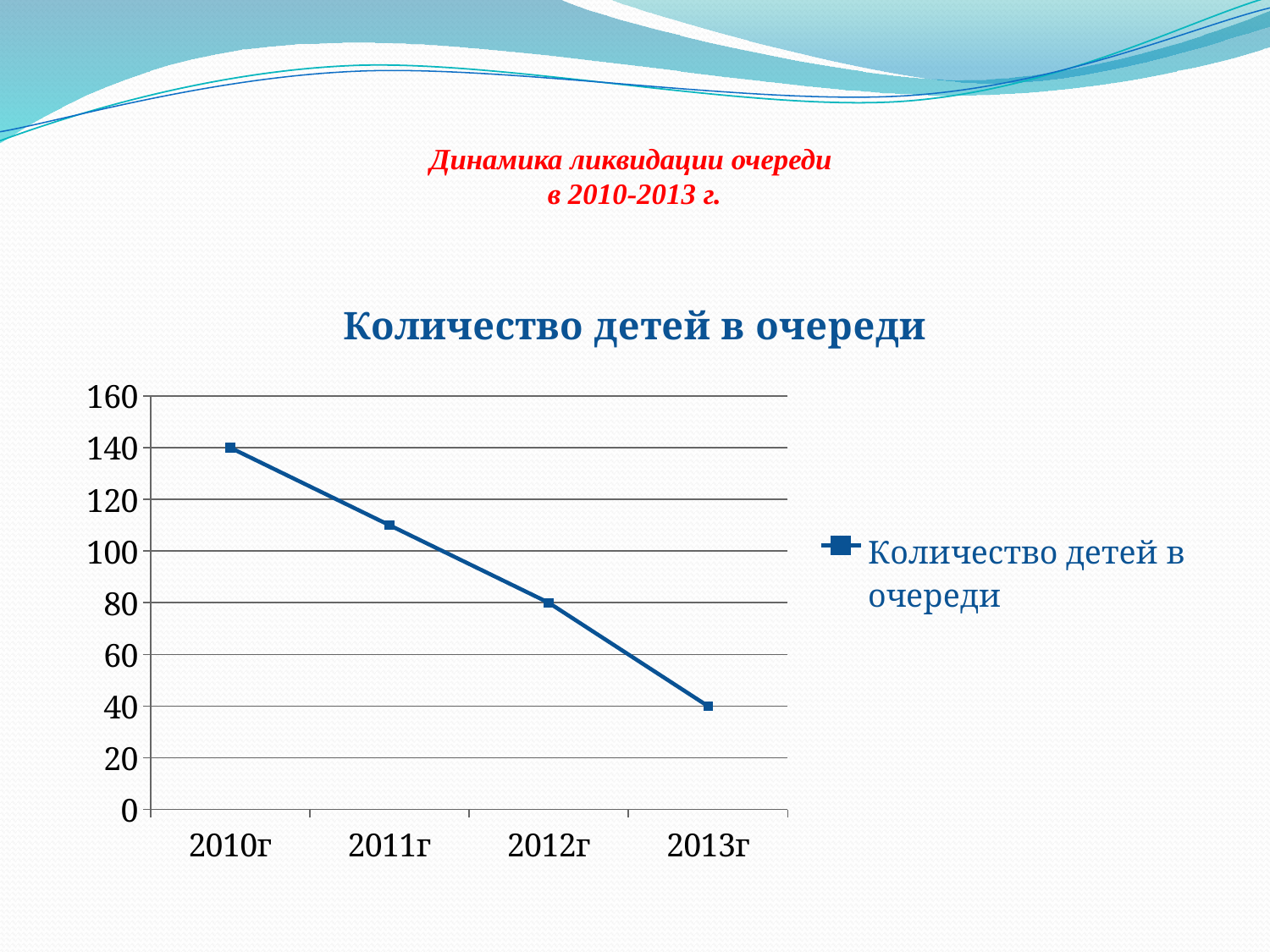
How many years are plotted on the x axis? 4 Is the value for 2011г greater or less than 100? greater Do the values rise or fall from 2010г to 2013г? fall What is the value for 2012г? 80 What is the value for 2013г? 40 What is the title of the chart? Количество детей в очереди What is the value for 2010г? 140 Which year has the lowest number of children in the queue? 2013г Which year has the highest number of children in the queue? 2010г What is the difference between the values for 2010г and 2013г? 100 How many series does the legend list? 1 What type of chart is shown on the slide? line chart